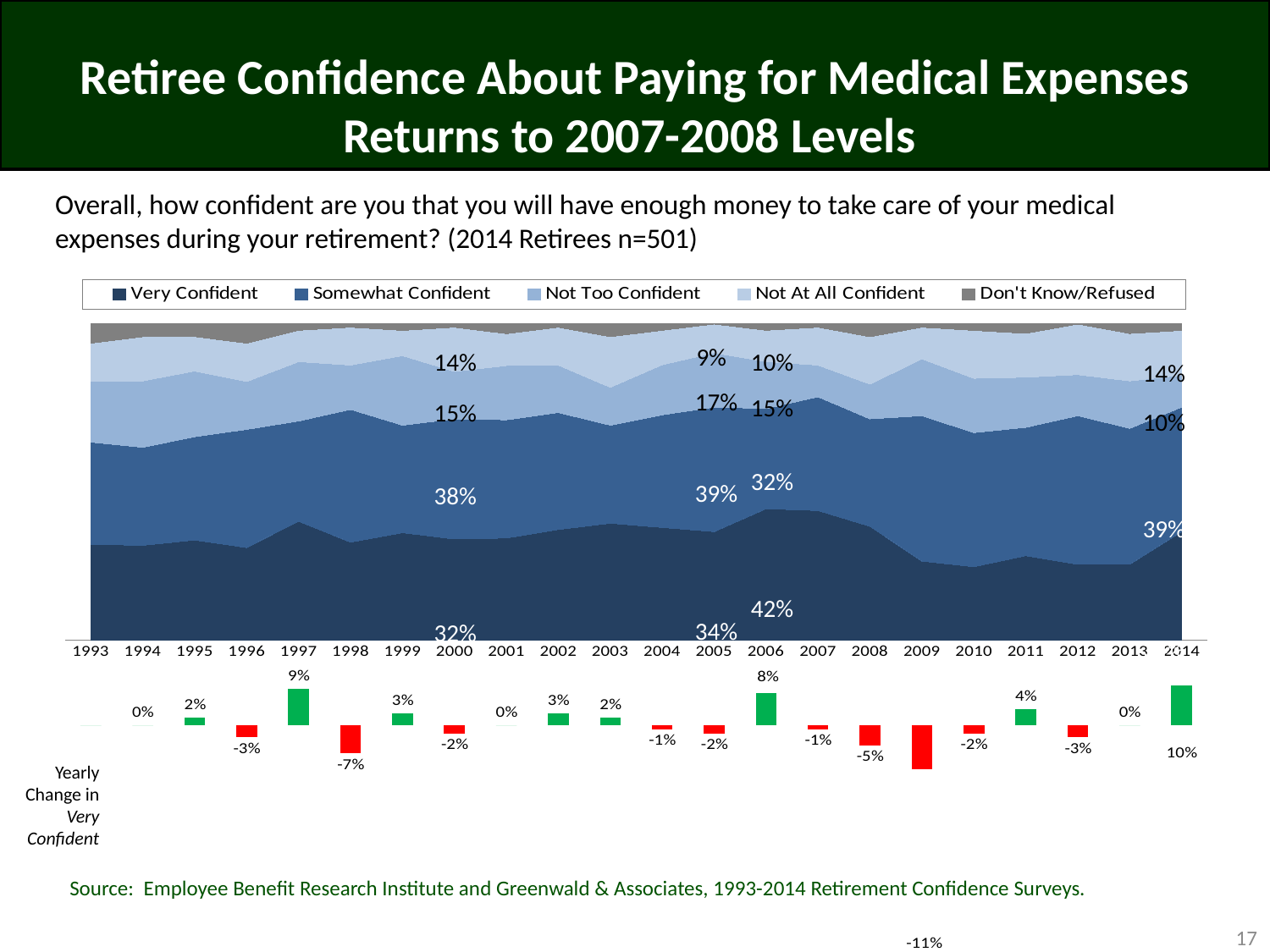
In the top chart, what percentage of retirees were Not At All Confident in 2000? 14% In the bottom chart, what was the yearly change in Very Confident for 2014? 10% In the bottom chart, which year shows the largest increase in Very Confident? 2014 How many series does the legend of the top chart list? 5 In the top chart for 2006, which was larger: Very Confident or Somewhat Confident? Very Confident In the top chart, by how many percentage points did the Very Confident share in 2006 exceed that in 2000? 10% In the top chart, what percentage of retirees were Very Confident in 2005? 34% In the bottom chart, which year shows the largest decrease in Very Confident? 2009 In the top chart, what percentage of retirees were Somewhat Confident in 2006? 32% In the bottom chart, what was the yearly change in Very Confident for 1997? 9% What kind of chart is the bottom chart showing yearly change in Very Confident? bar chart